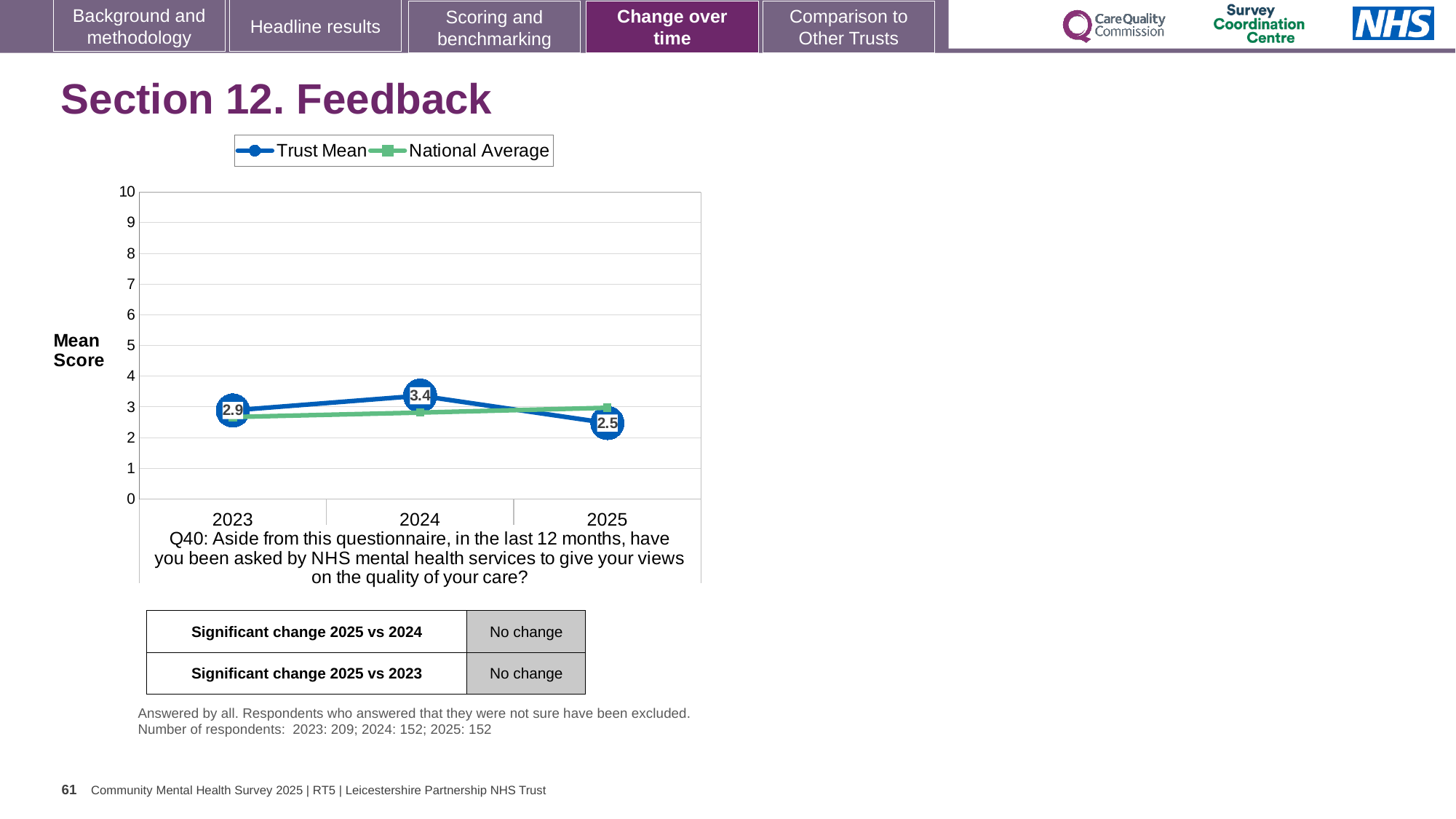
What is the Trust Mean score for 2024? 3.4 In 2024, which is higher: the Trust Mean or the National Average? Trust Mean What is the Trust Mean score for 2025? 2.5 What is the Trust Mean score for 2023? 2.9 Is the National Average value for 2025 greater or less than 4? less In 2025, which is higher: the Trust Mean or the National Average? National Average How many series does the chart legend list? 2 What is the difference between the Trust Mean scores for 2024 and 2025? 0.9 How many years are shown on the x axis of the chart? 3 What kind of chart is shown on the slide? Line chart In which year is the Trust Mean score lowest? 2025 In which year is the Trust Mean score highest? 2024